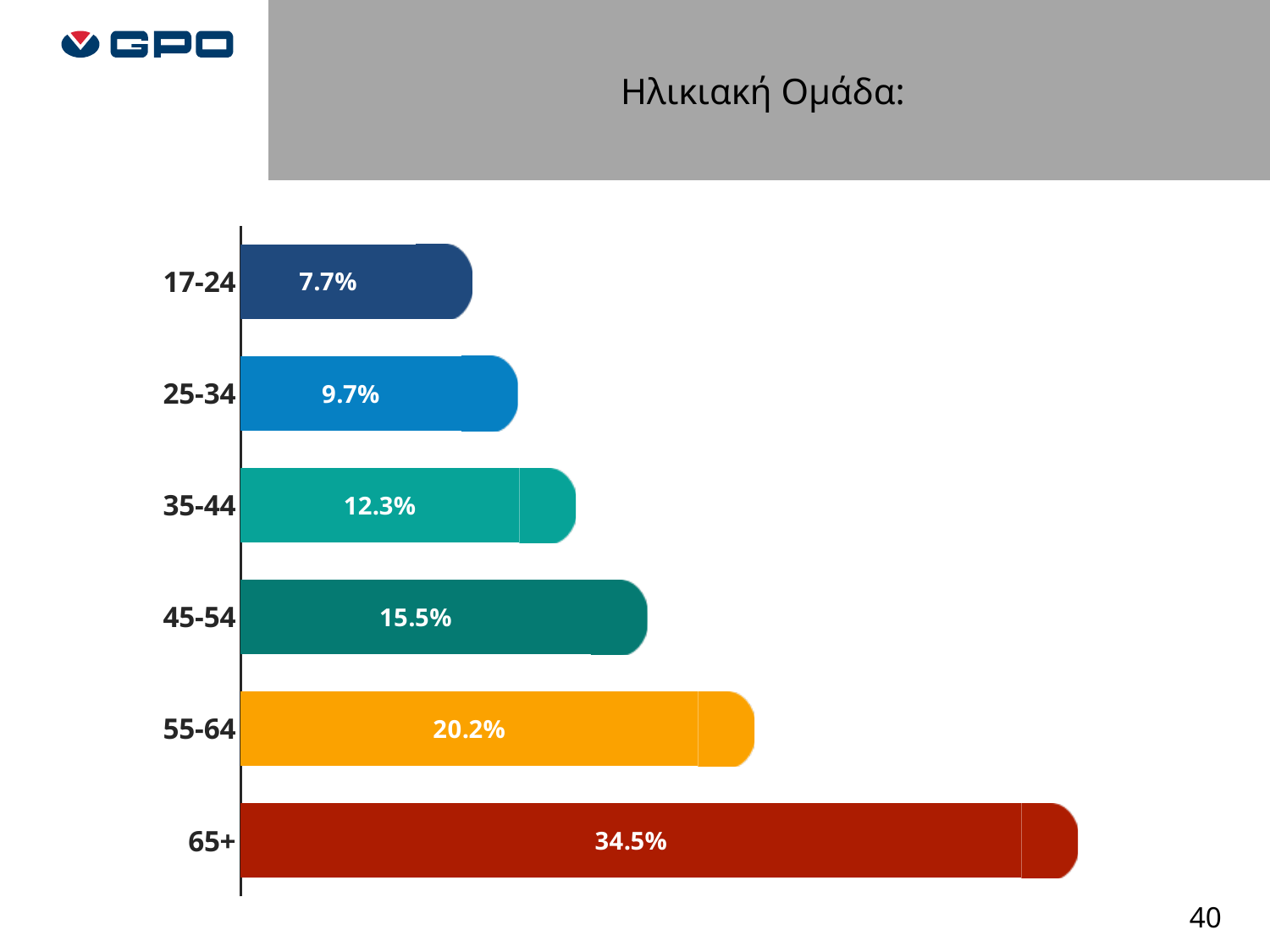
What is the value for the 65+ age group? 34.5% What kind of chart is shown on the slide? Bar chart What is the title of the chart? Ηλικιακή Ομάδα: How many age groups are shown in the chart? 6 Do the values rise or fall going from the 17-24 group down to the 65+ group? Rise What is the value for the 45-54 age group? 15.5% What is the difference between the values for 65+ and 55-64? 14.3% Which age group has the highest value? 65+ Which is larger, the value for 45-54 or the value for 25-34? 45-54 What is the difference between the values for 35-44 and 17-24? 4.6% Which age group has the lowest value? 17-24 What is the value for the 25-34 age group? 9.7%